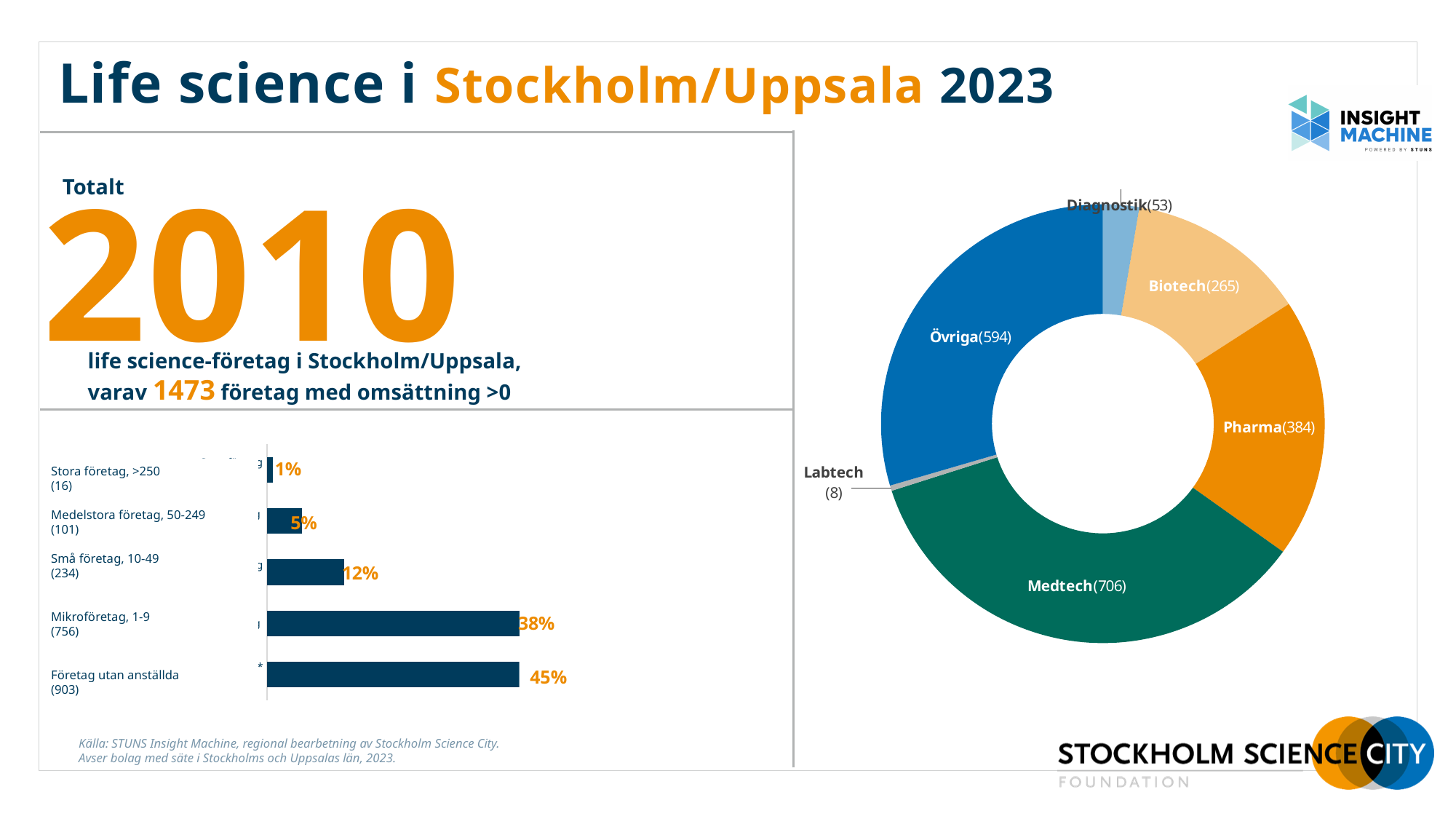
How many categories does the donut chart on the right show? 6 In the donut chart on the right, which is larger, Pharma or Biotech? Pharma In the donut chart on the right, what is the difference between the values for Övriga and Pharma? 210 In the bar chart on the left, what percentage is shown for Mikroföretag, 1-9? 38% In the bar chart on the left, what is the difference in percentage points between Företag utan anställda and Mikroföretag, 1-9? 7 In the donut chart on the right, what is the value for Medtech? 706 What type of chart is shown on the left side of the slide? Bar chart In the bar chart on the left, what percentage is shown for Små företag, 10-49? 12% In the bar chart on the left, which category has the highest percentage? Företag utan anställda In the donut chart on the right, what is the value for Biotech? 265 In the donut chart on the right, which category has the highest value? Medtech In the donut chart on the right, which category has the lowest value? Labtech